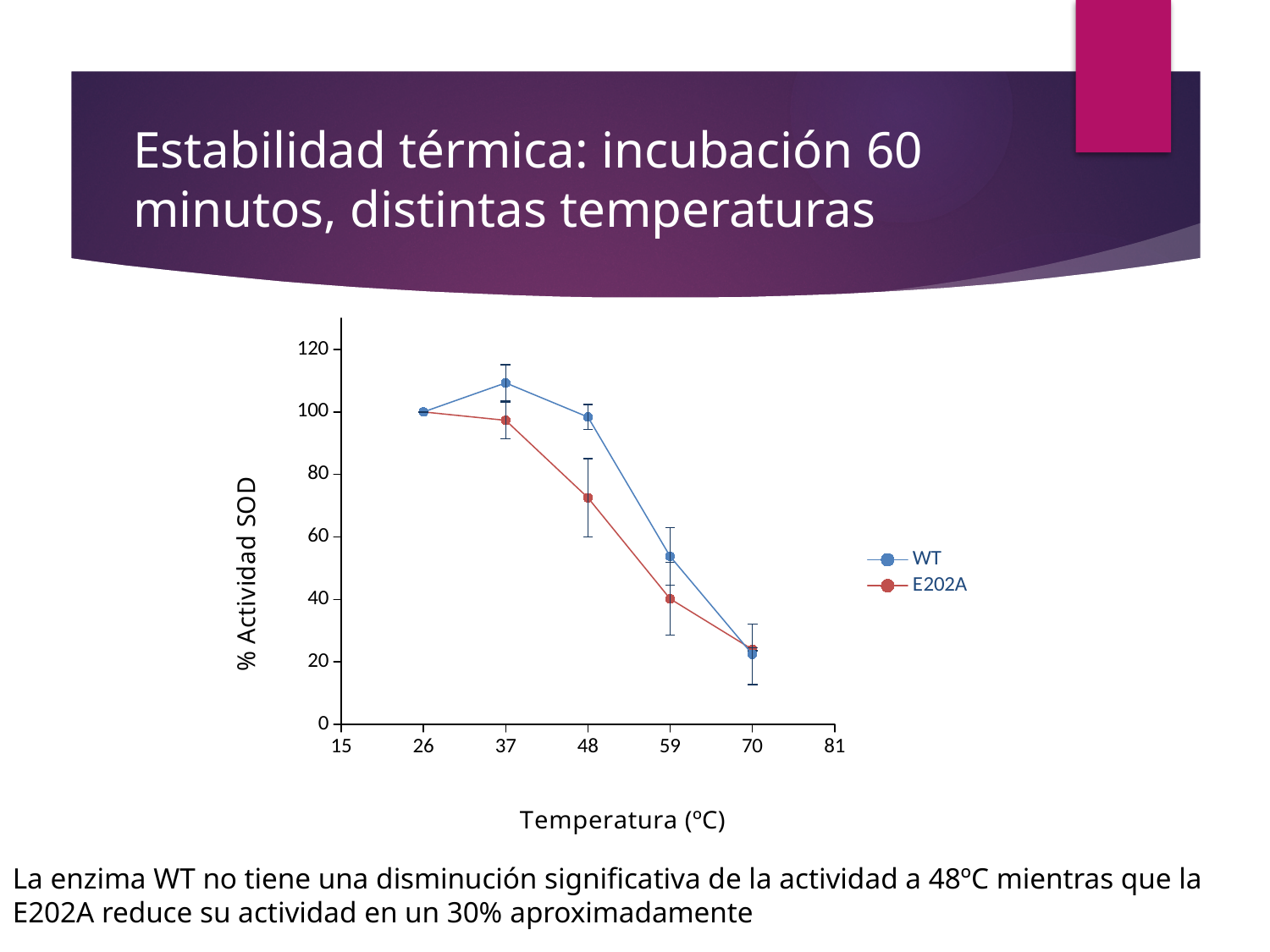
Is the value for WT at 37 °C greater or less than 100? greater At which temperature does the WT series reach its highest value? 37 What is the label of the y axis? % Actividad SOD What kind of chart is shown on the slide? line chart How many temperature points are plotted for the WT series? 5 Is the value for E202A at 48 °C greater or less than 80? less At 48 °C, which series has the higher value, WT or E202A? WT At which temperature does the E202A series reach its lowest value? 70 Is the value for WT at 59 °C greater or less than 40? greater How many series does the legend list? 2 Does the E202A series rise or fall as temperature increases from 37 to 70 °C? fall Which series is drawn in red? E202A